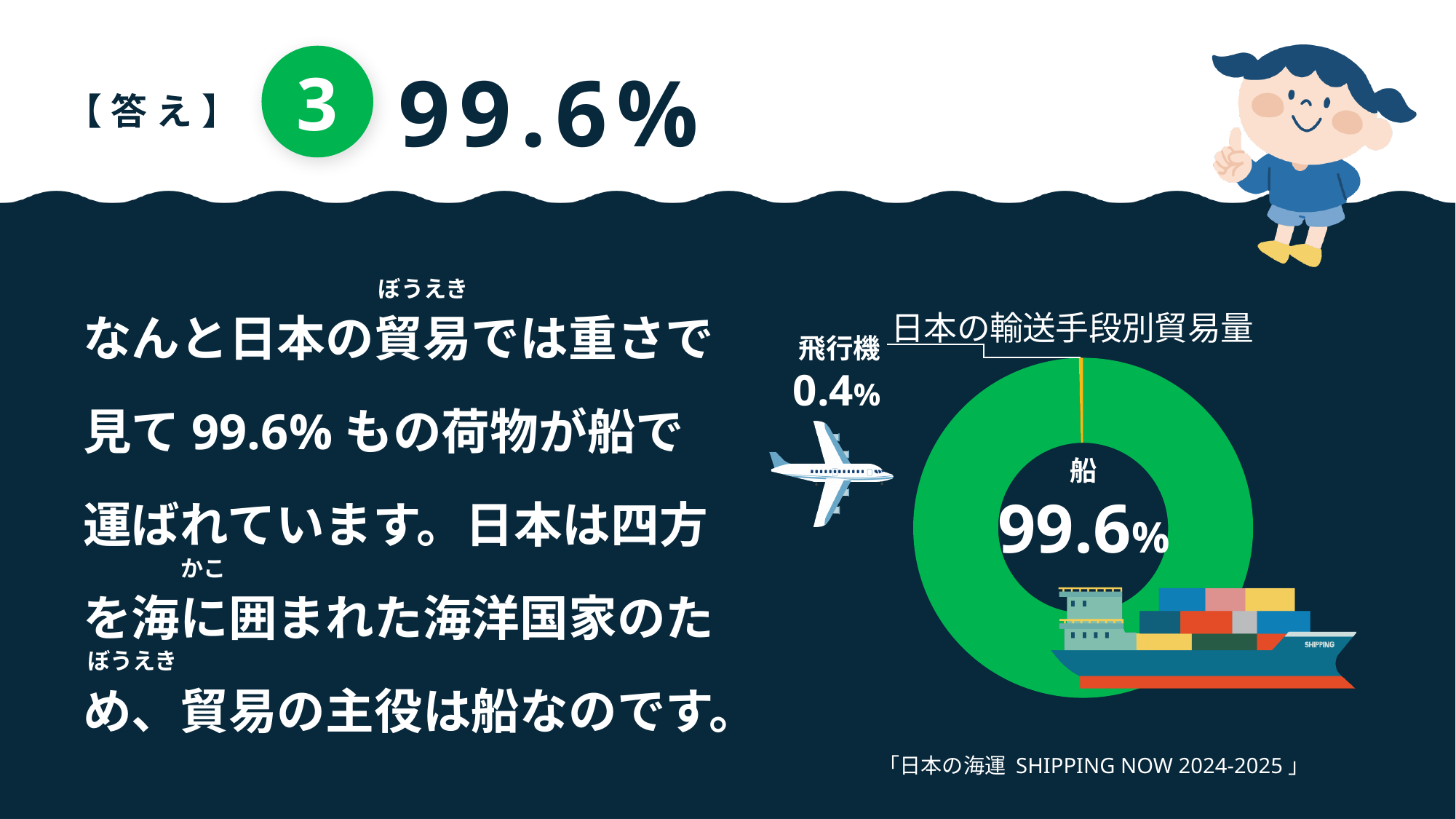
What kind of chart is shown on the slide? doughnut chart What share of the pie does the 船 slice represent? 99.6% What percentage of the chart is labelled 船? 99.6% What is the title of the chart? 日本の輸送手段別貿易量 What is the difference between the share for 船 and the share for 飛行機? 99.2% What percentage of the chart is labelled 飛行機? 0.4% Which category has the smallest share in the chart? 飛行機 Which is larger, the share for 船 or the share for 飛行機? 船 What source is cited below the chart? 「日本の海運 SHIPPING NOW 2024-2025」 How many categories are shown in the chart? 2 Which category has the largest share in the chart? 船